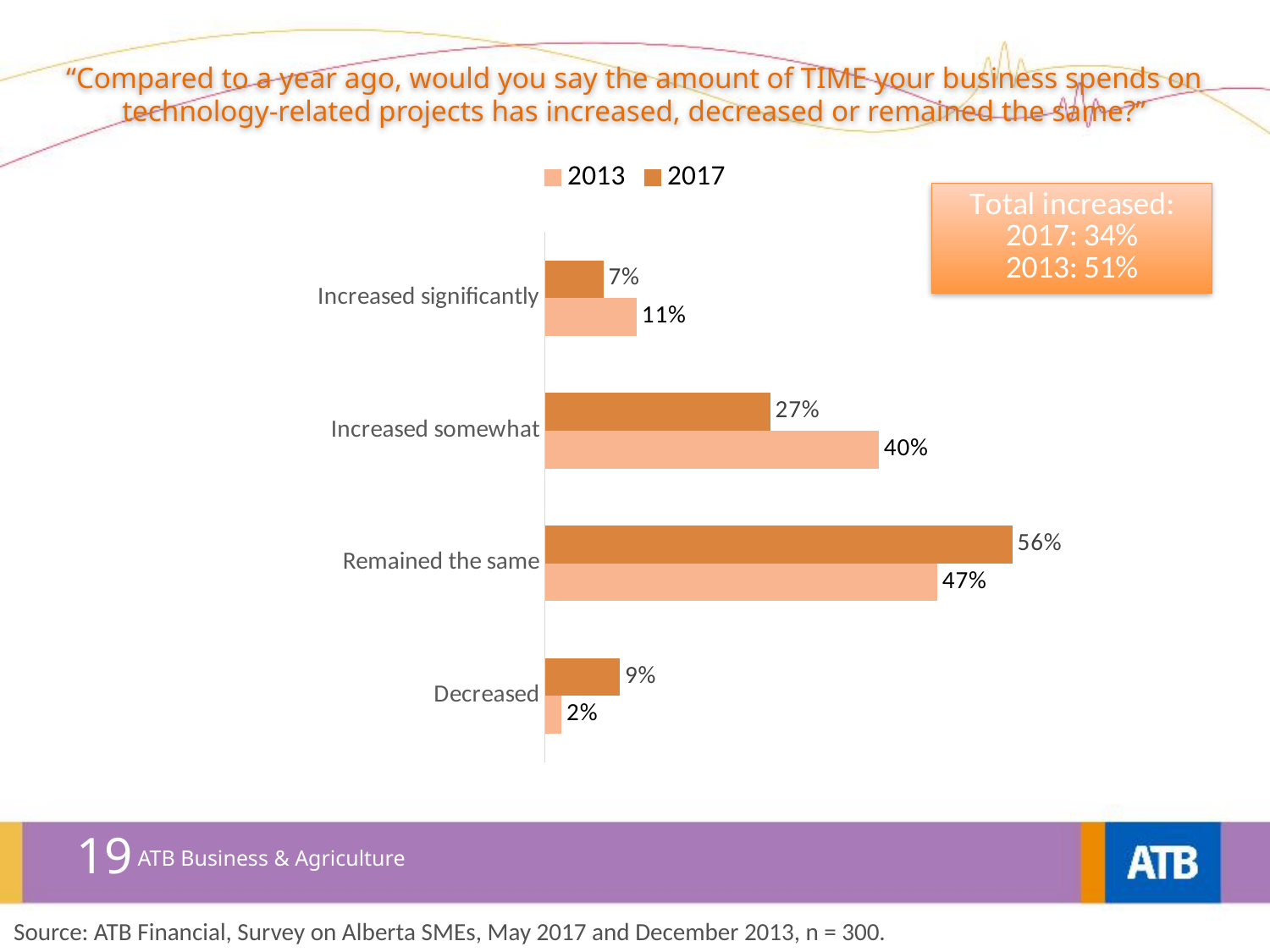
What is the 2013 value for "Decreased"? 2% What is the difference between the 2013 and 2017 values for "Increased somewhat"? 13% What is the 2017 value for "Increased significantly"? 7% Which is larger for "Decreased": the 2013 value or the 2017 value? 2017 Which category has the lowest 2013 value? Decreased What is the 2017 value for "Remained the same"? 56% How many categories are shown on the chart? 4 According to the box on the slide, what was the total increased share in 2013? 51% How many series does the legend list? 2 What is the 2013 value for "Increased somewhat"? 40% What kind of chart is shown on the slide? Bar chart Which category has the highest 2017 value? Remained the same